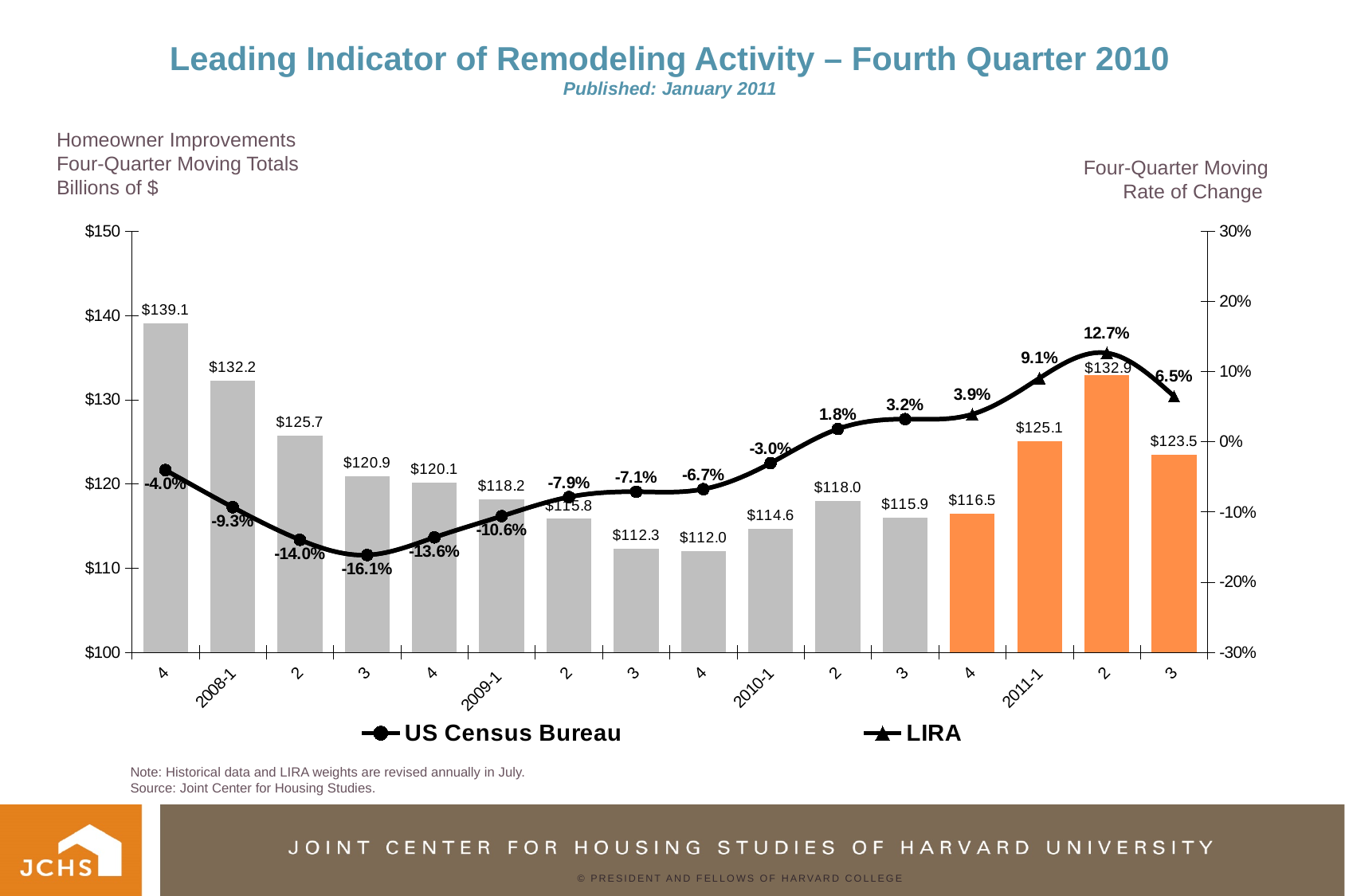
Which is larger, the four-quarter moving total for 2010-2 or for 2010-3? 2010-2 Do the bar values rise or fall from 2008-1 through 2009-4? Fall How many bars are plotted on the chart? 16 What is the difference between the four-quarter moving totals for 2011-2 and 2011-1? $7.8 What kind of chart is shown on the slide? Combination bar and line chart How many series does the legend list? 2 Which quarter has the lowest four-quarter moving rate of change on the line? 2008-3 (-16.1%) Which bar has the lowest four-quarter moving total? 2009-4 ($112.0) What is the four-quarter moving rate of change shown for 2010-1? -3.0% What is the four-quarter moving total shown for 2011-1? $125.1 Which quarter has the highest four-quarter moving rate of change on the line? 2011-2 (12.7%) What is the four-quarter moving total shown for 2008-1? $132.2